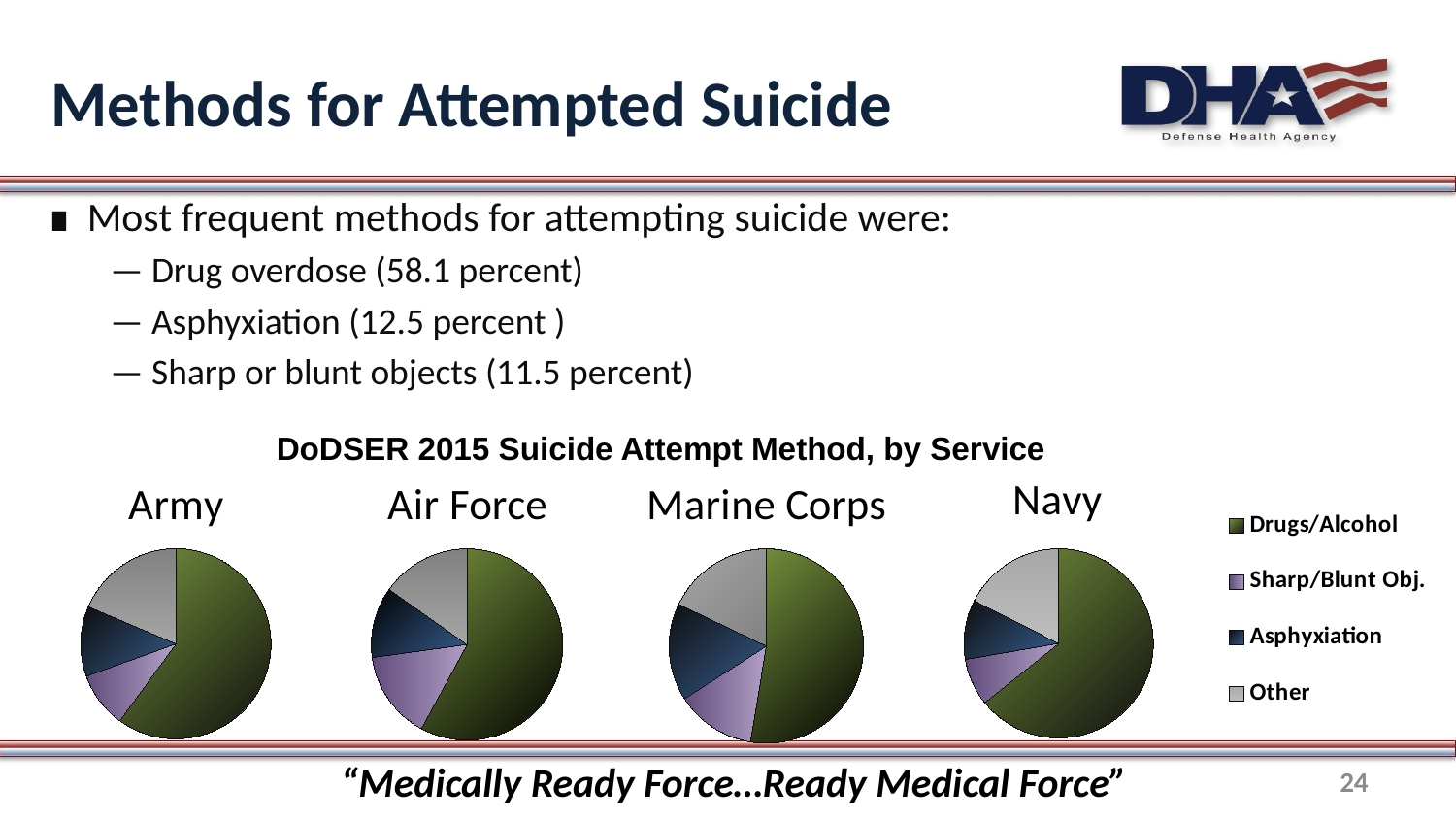
In the Marine Corps pie chart, which slice is larger: Drugs/Alcohol or Other? Drugs/Alcohol In the Air Force pie chart, which method has the smallest slice? Asphyxiation How many pie charts are shown on the slide? 4 What is the title of the group of pie charts? DoDSER 2015 Suicide Attempt Method, by Service Which legend entry is shown in green in the pie charts? Drugs/Alcohol In the Army pie chart, which slice is larger: Other or Sharp/Blunt Obj.? Other What kind of charts are shown under the title 'DoDSER 2015 Suicide Attempt Method, by Service'? Pie charts In the Navy pie chart, which method has the smallest slice? Sharp/Blunt Obj. In the Army pie chart, which method has the largest slice? Drugs/Alcohol In the Army pie chart, which method has the smallest slice? Sharp/Blunt Obj. In the Navy pie chart, which method has the largest slice? Drugs/Alcohol How many categories does the legend list for the pie charts? 4